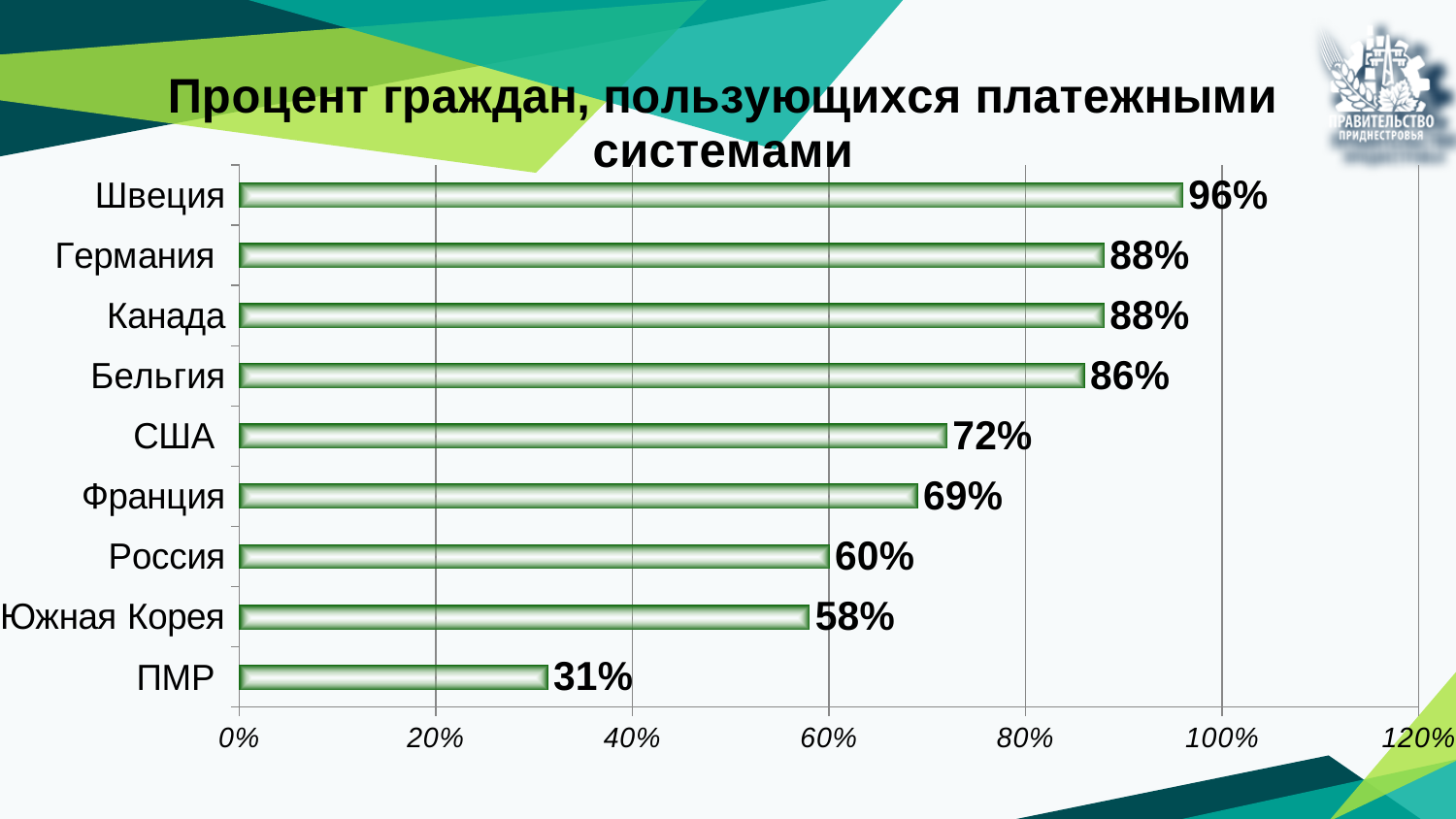
What is the difference between the values for Швеция and ПМР? 65% What is the value for Россия? 60% What is the difference between the values for США and Франция? 3% Which country has the highest value? Швеция How many countries are shown in the chart? 9 Which country has the lowest value? ПМР What kind of chart is shown on the slide? bar chart What is the title of the chart? Процент граждан, пользующихся платежными системами What is the value for ПМР? 31% Which is larger, the value for Бельгия or the value for США? Бельгия What is the value for Швеция? 96% Is the value for Южная Корея greater or less than 60%? less